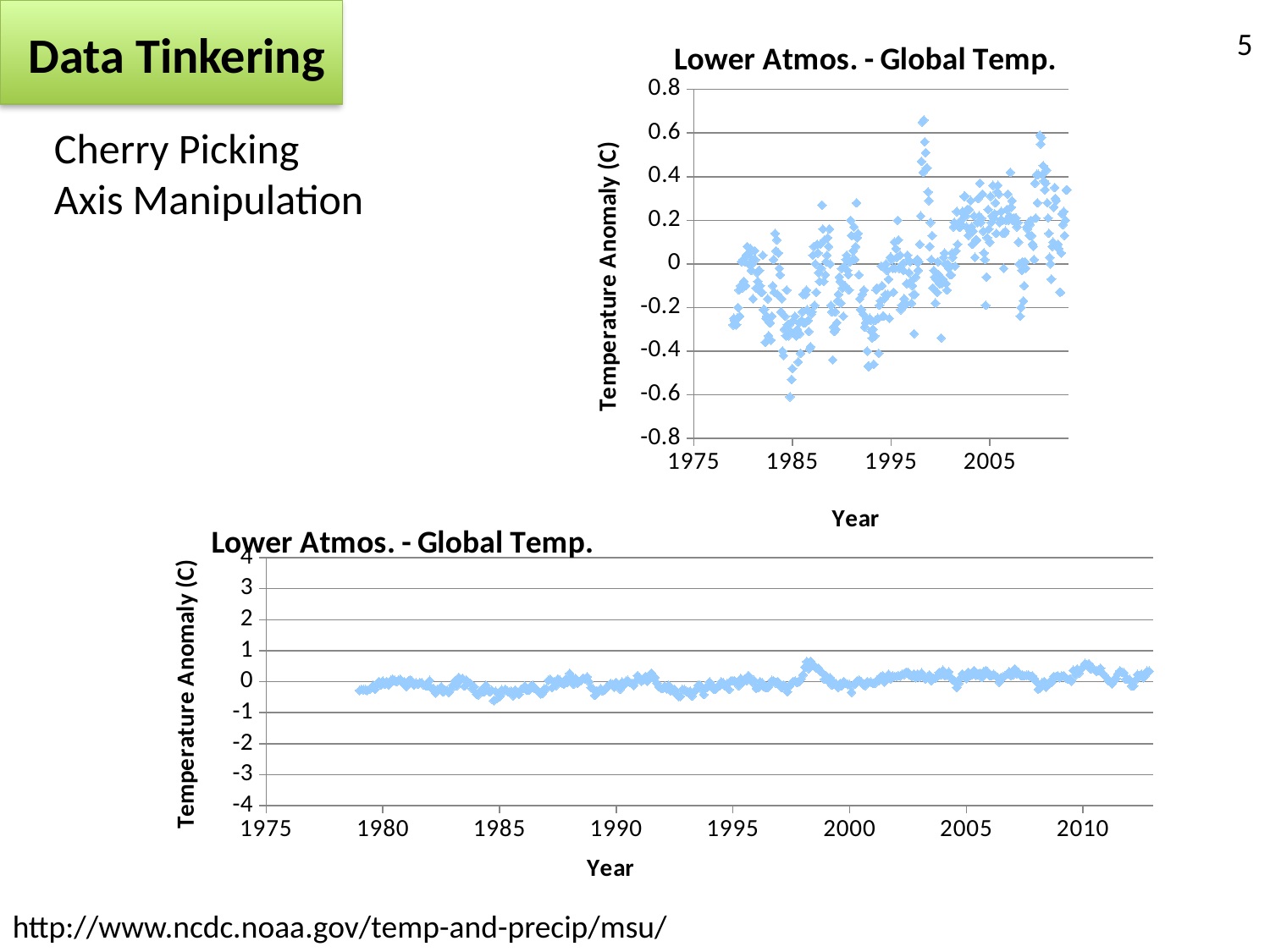
In the bottom chart, is the lowest plotted temperature anomaly greater or less than -1? greater In the top-right chart, is the lowest plotted temperature anomaly greater or less than -0.4? less What kind of chart is the bottom chart on the slide? scatter chart What is the maximum value shown on the y-axis of the bottom chart? 4 What kind of chart is the top-right chart on the slide? scatter chart In the top-right chart, is the highest plotted temperature anomaly greater or less than 0.4? greater What is the title of the top-right chart? Lower Atmos. - Global Temp. In the top-right chart, do the temperature anomaly values generally rise or fall as the year increases? rise In the bottom chart, do the temperature anomaly values generally rise or fall from 1980 to 2010? rise